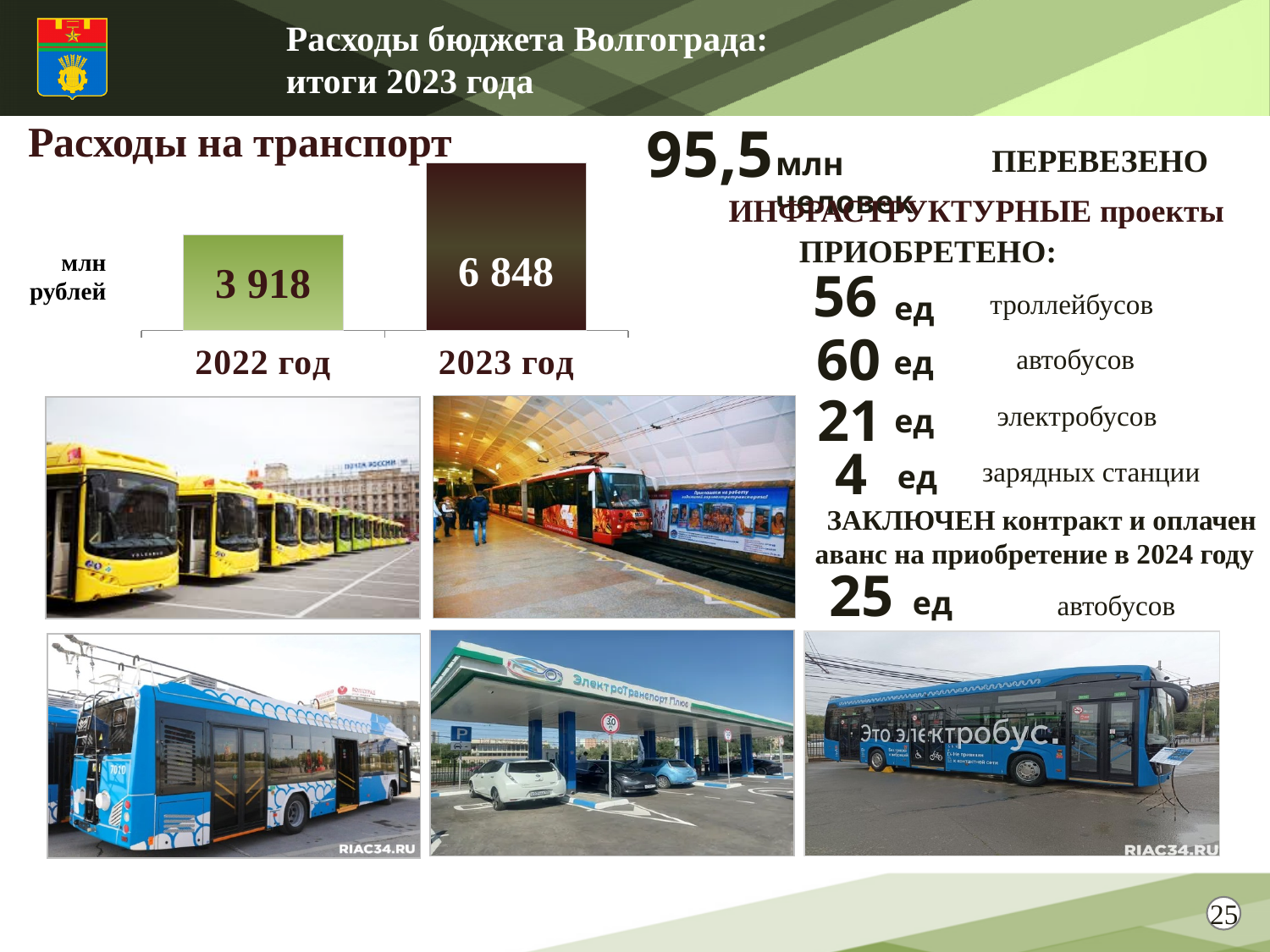
What is the title of the bar chart on the slide? Расходы на транспорт What is the value for 2023 год in the 'Расходы на транспорт' chart? 6 848 How many bars are shown in the 'Расходы на транспорт' chart? 2 Which year has the lower value in the 'Расходы на транспорт' chart? 2022 год Which year has the higher value in the 'Расходы на транспорт' chart? 2023 год Do the values in the 'Расходы на транспорт' chart rise or fall from 2022 год to 2023 год? rise What is the difference between the 2023 год and 2022 год values in the 'Расходы на транспорт' chart? 2 930 What unit is indicated for the values in the 'Расходы на транспорт' chart? млн рублей What is the value for 2022 год in the 'Расходы на транспорт' chart? 3 918 What type of chart is used for 'Расходы на транспорт'? bar chart In the 'Расходы на транспорт' chart, is the value for 2022 год larger or smaller than the value for 2023 год? smaller